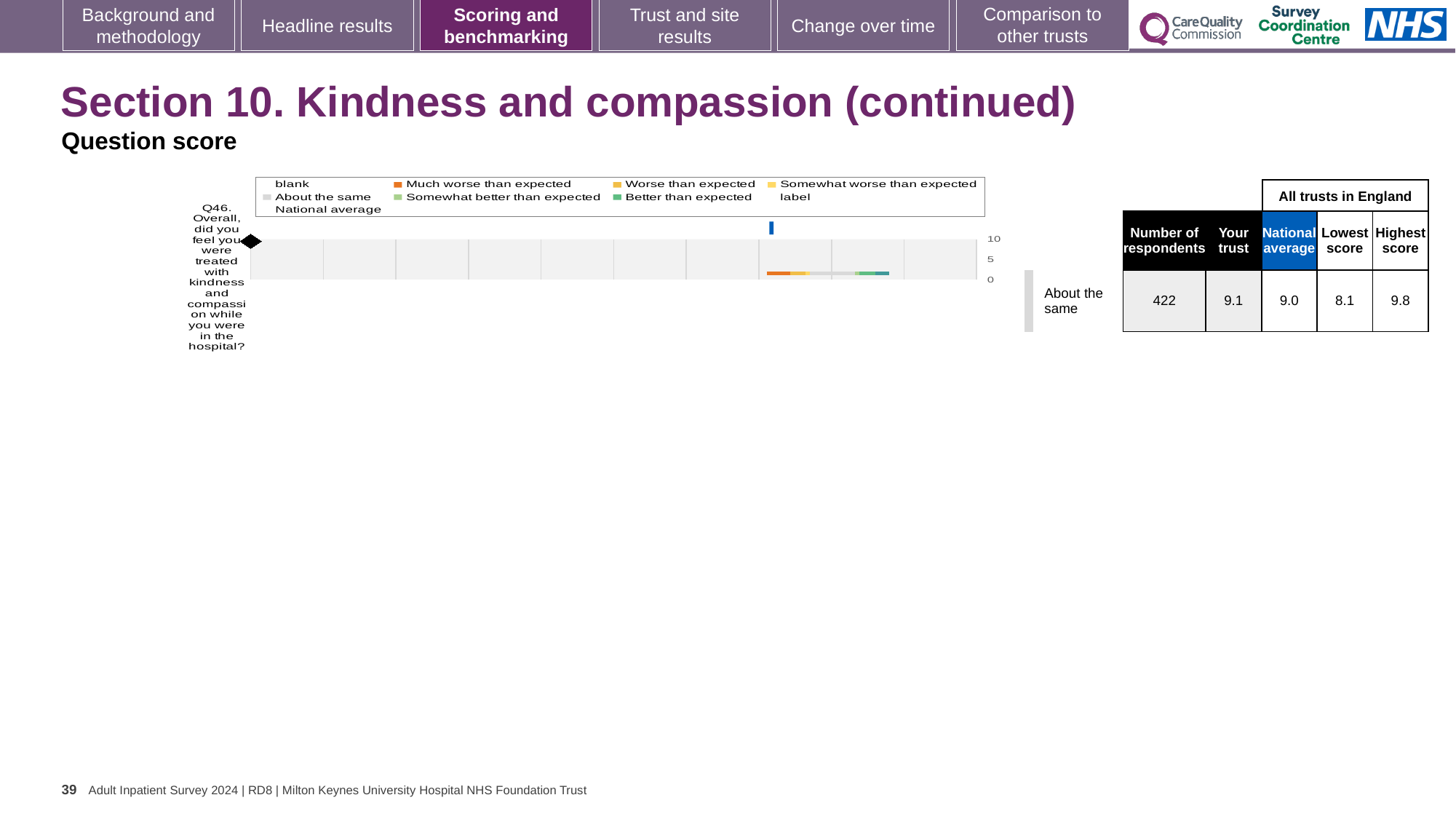
What is the difference between the Highest score and the Lowest score for Q46? 1.7 Which is larger for Q46, the Your trust score or the National average score? Your trust What kind of chart is shown on the slide? bar chart According to the table next to the chart, what is the National average score for Q46? 9.0 What is the highest tick value shown on the chart's axis? 10 According to the table next to the chart, what is the Highest score among all trusts in England for Q46? 9.8 According to the table next to the chart, what is the score for Your trust on Q46? 9.1 Which question is plotted in the chart? Q46. Overall, did you feel you were treated with kindness and compassion while you were in the hospital? Which legend entry is shown in orange? Much worse than expected How many questions (categories) are plotted in the chart? 1 According to the table next to the chart, how many respondents answered Q46? 422 According to the table next to the chart, what is the Lowest score among all trusts in England for Q46? 8.1